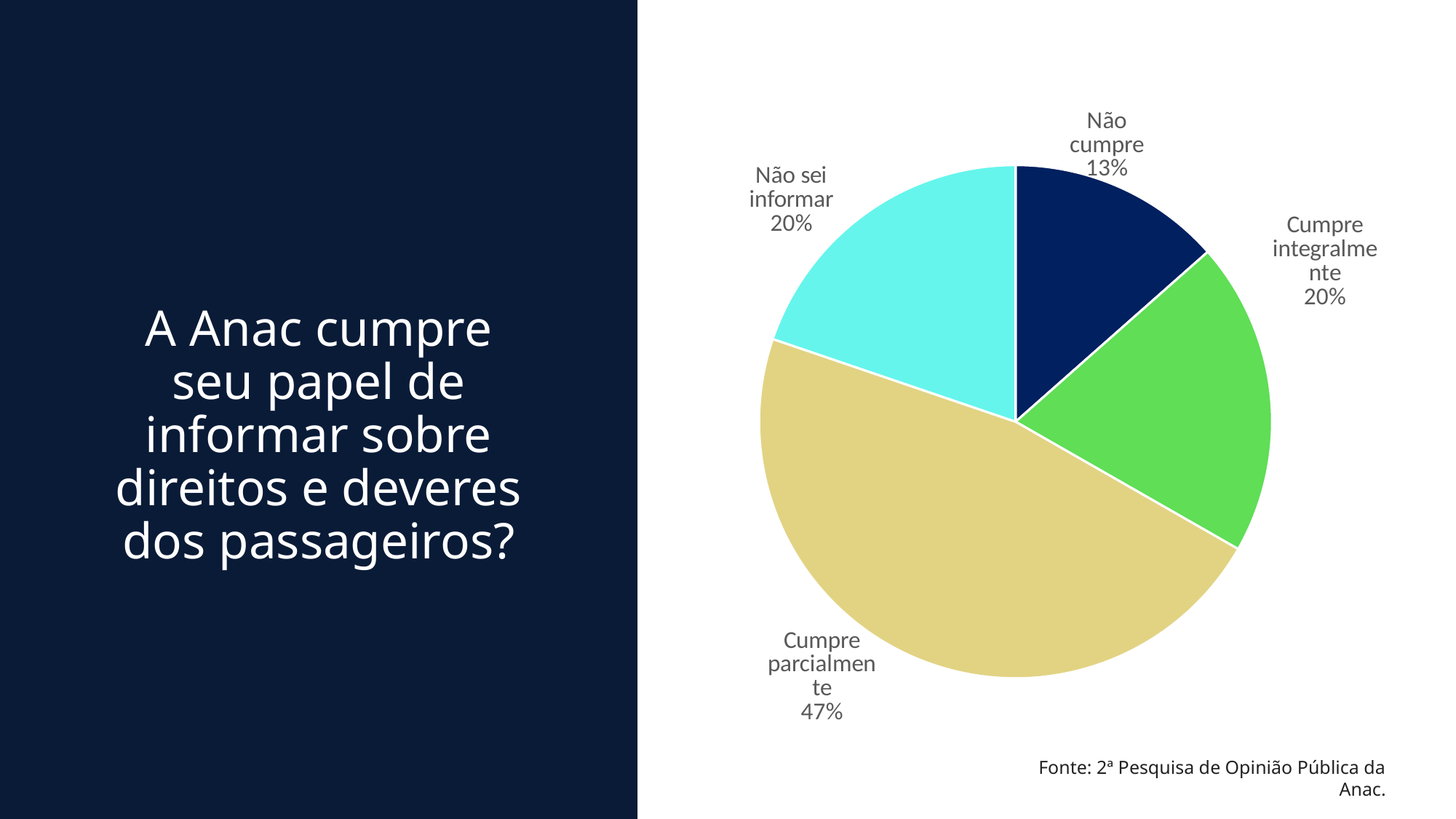
What share of respondents answered "Não cumpre"? 13% Which response has the smallest slice of the pie? Não cumpre Which response has the largest slice of the pie? Cumpre parcialmente What share of respondents answered "Não sei informar"? 20% What is the combined share of "Cumpre integralmente" and "Cumpre parcialmente"? 67% Which is larger, the share for "Cumpre integralmente" or the share for "Não cumpre"? Cumpre integralmente What share of respondents answered "Cumpre parcialmente"? 47% What is the difference in percentage points between "Cumpre parcialmente" and "Não cumpre"? 34 percentage points What share of respondents answered "Cumpre integralmente"? 20% What source is cited for the chart data? 2ª Pesquisa de Opinião Pública da Anac How many slices does the pie chart have? 4 What kind of chart is shown on the slide? pie chart